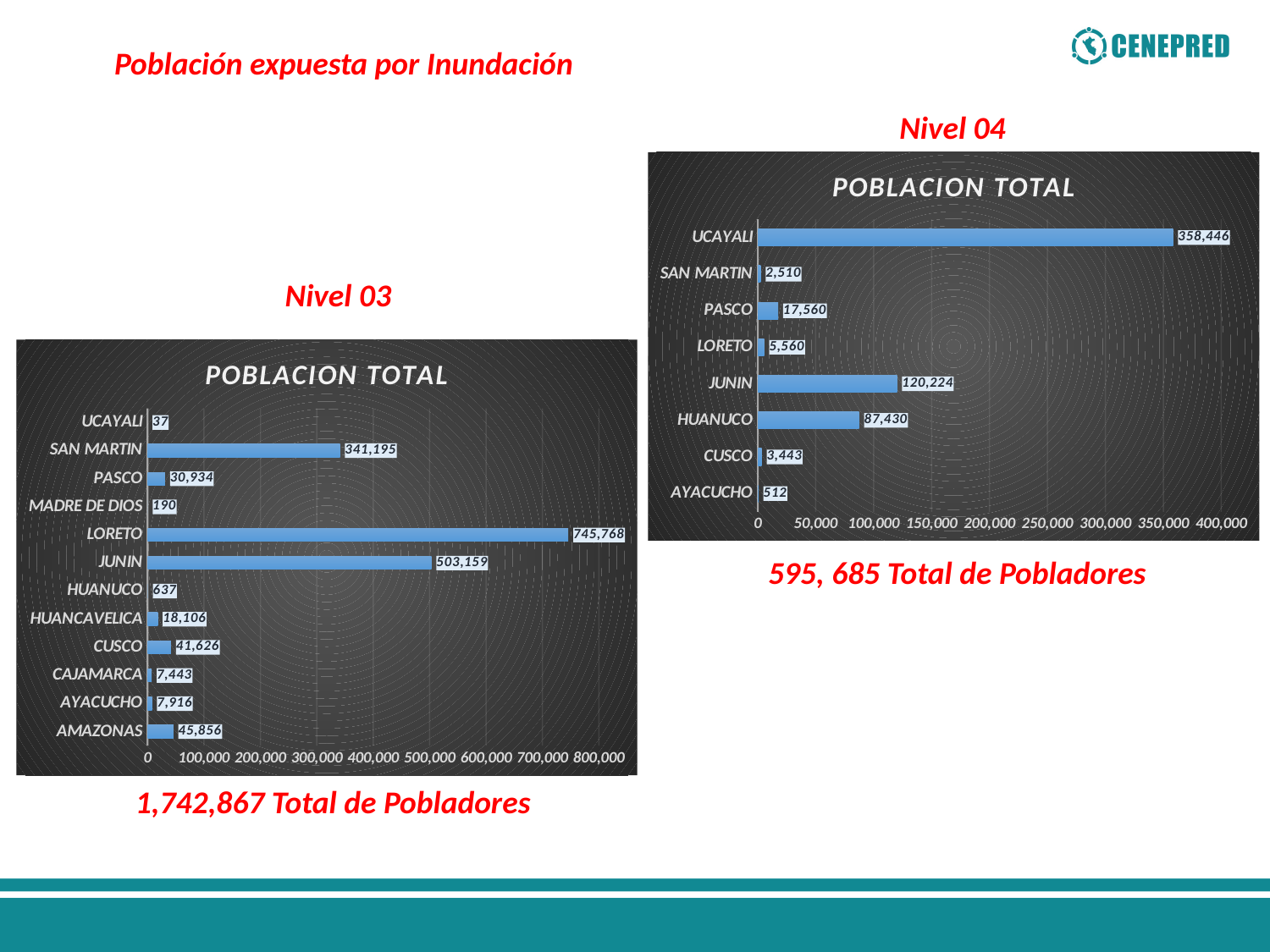
In the Nivel 04 chart, which is larger, the value for PASCO or the value for LORETO? PASCO In the Nivel 04 chart, what is the value for HUANUCO? 87,430 What kind of chart is the Nivel 04 chart? Bar chart How many categories are shown in the Nivel 03 chart? 12 In the Nivel 04 chart, what is the difference between the values for UCAYALI and JUNIN? 238,222 In the Nivel 03 chart, what is the value for LORETO? 745,768 In the Nivel 03 chart, what is the difference between the values for LORETO and JUNIN? 242,609 In the Nivel 03 chart, what is the value for SAN MARTIN? 341,195 In the Nivel 03 chart, which category has the lowest value? UCAYALI In the Nivel 03 chart, is the value for JUNIN greater or less than 500,000? greater In the Nivel 04 chart, which category has the highest value? UCAYALI How many categories are shown in the Nivel 04 chart? 8